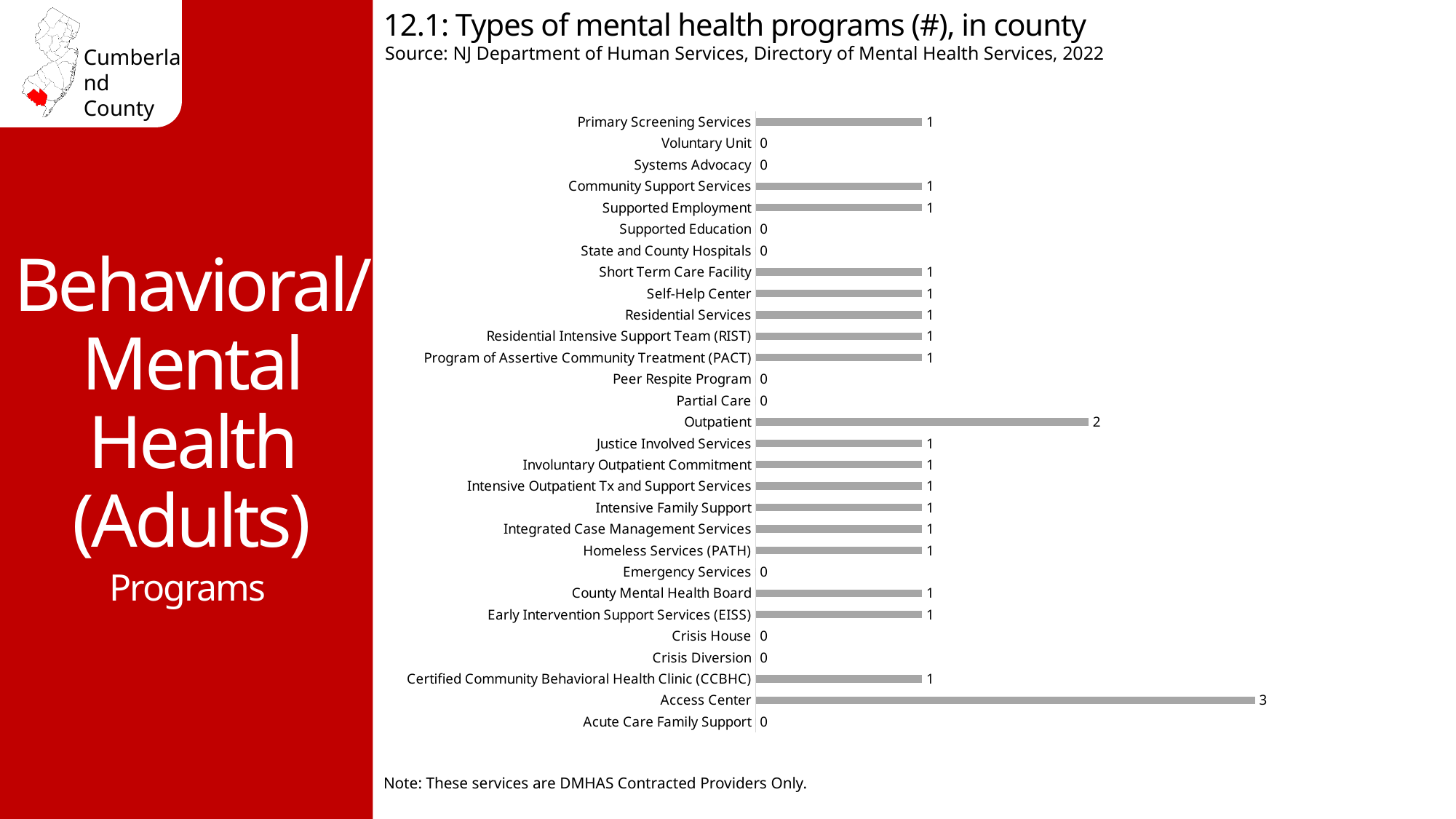
Which is larger, the value for Supported Employment or the value for Supported Education? Supported Employment What is the title of the chart? 12.1: Types of mental health programs (#), in county Which is larger, the value for Outpatient or the value for Self-Help Center? Outpatient What kind of chart is shown on the slide? Bar chart What is the value for Homeless Services (PATH)? 1 How many program types are listed on the chart? 29 How many program types have a value of 0? 10 What is the value for Partial Care? 0 What is the value for Outpatient? 2 What is the value for Access Center? 3 Which program type has the highest number of programs? Access Center What is the difference between the values for Access Center and Outpatient? 1